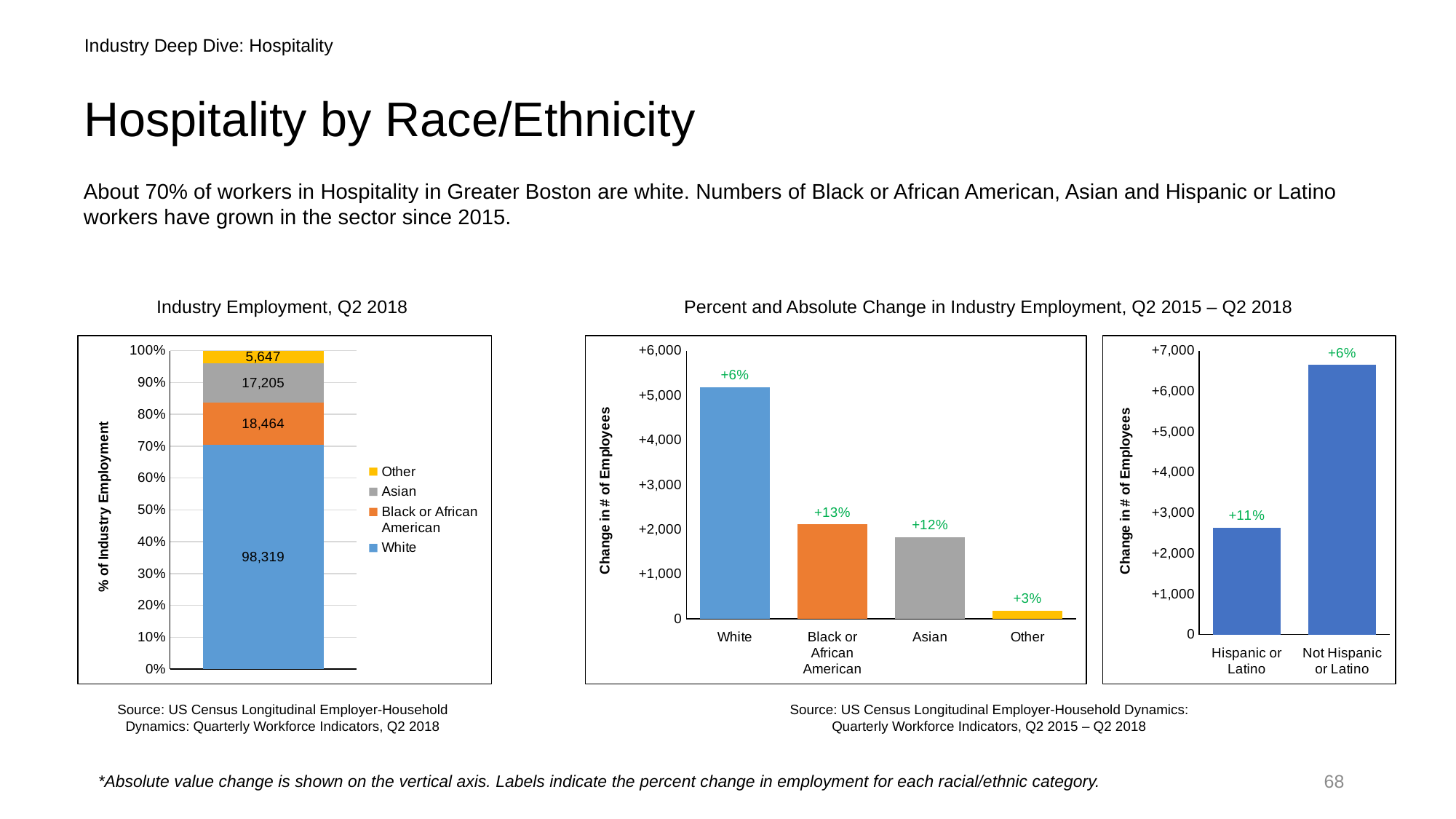
In the middle chart (Percent and Absolute Change in Industry Employment by race), is the change in number of employees for Asian greater or less than 2,000? less How many categories are shown on the x axis of the middle chart (Percent and Absolute Change in Industry Employment by race)? 4 In the Industry Employment, Q2 2018 chart, which group has the smallest value? Other In the rightmost chart (Hispanic or Latino vs Not Hispanic or Latino), is the change in number of employees for Not Hispanic or Latino greater or less than 6,000? greater In the Industry Employment, Q2 2018 chart, what is the difference between the Black or African American value and the Asian value? 1,259 In the rightmost chart (Hispanic or Latino vs Not Hispanic or Latino), what percent change label is shown for Hispanic or Latino? +11% In the Industry Employment, Q2 2018 chart, what is the total of the stacked bar? 139,635 In the middle chart (Percent and Absolute Change in Industry Employment by race), what percent change label is shown for Black or African American? +13% In the Industry Employment, Q2 2018 chart, what is the value for Asian? 17,205 How many series does the legend of the Industry Employment, Q2 2018 chart list? 4 In the Industry Employment, Q2 2018 chart, what is the value for White? 98,319 In the middle chart (Percent and Absolute Change in Industry Employment by race), which category has the largest absolute change in number of employees? White